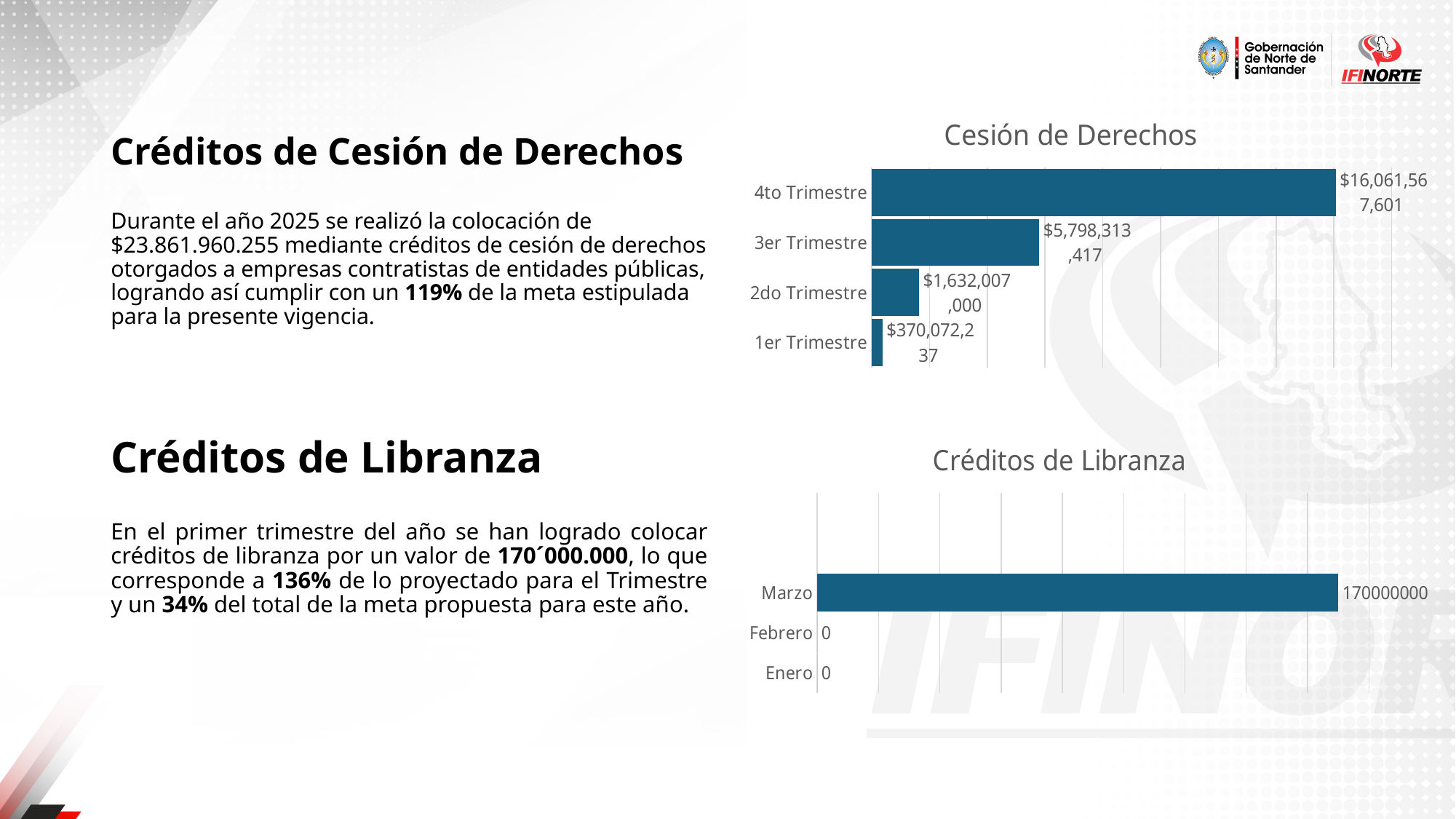
In the 'Cesión de Derechos' chart, what is the value for 3er Trimestre? $5,798,313,417 What kind of chart is the 'Cesión de Derechos' chart? Bar chart In the 'Cesión de Derechos' chart, which quarter has the highest value? 4to Trimestre In the 'Cesión de Derechos' chart, what is the value for 2do Trimestre? $1,632,007,000 In the 'Cesión de Derechos' chart, what is the value for 4to Trimestre? $16,061,567,601 In the 'Créditos de Libranza' chart, what is the value for Febrero? 0 In the 'Créditos de Libranza' chart, what is the value for Marzo? 170000000 In the 'Créditos de Libranza' chart, how many months are shown? 3 In the 'Cesión de Derechos' chart, which quarter has the lowest value? 1er Trimestre In the 'Cesión de Derechos' chart, what is the value for 1er Trimestre? $370,072,237 In the 'Cesión de Derechos' chart, how many quarters are shown? 4 In the 'Cesión de Derechos' chart, which is larger, the value for 3er Trimestre or 2do Trimestre? 3er Trimestre